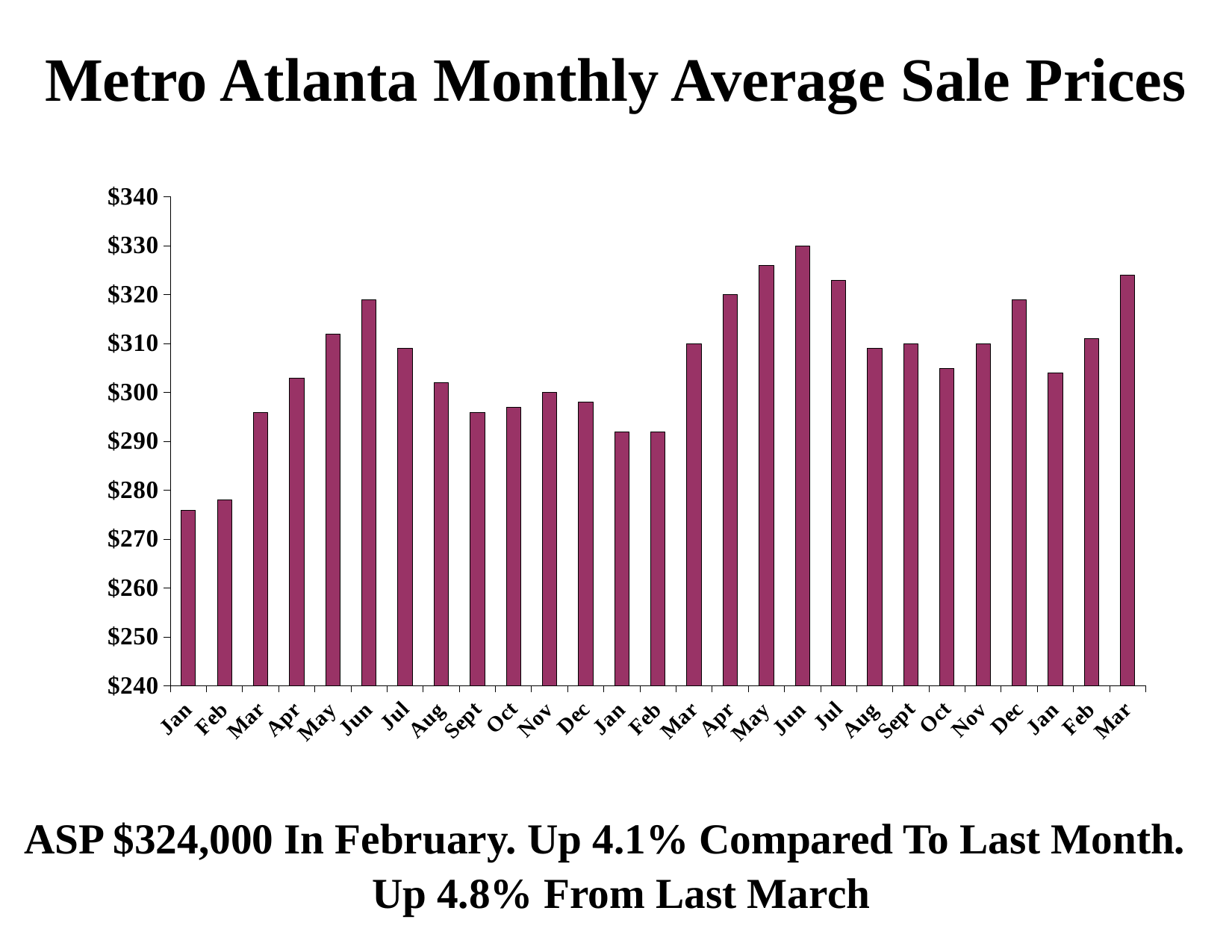
Is the value for the first Jun bar greater or less than $310? greater Which is larger, the first Mar bar or the first Jun bar? Jun Which month has the highest bar in the chart? Jun (the second Jun) Is the value for the first Jan bar greater or less than $280? less What kind of chart is shown on the slide? bar chart Do the values rise or fall from the first Jan to the first Jun? rise Which month has the lowest bar in the chart? Jan (the first Jan) Which is larger, the second May bar or the second Aug bar? May What is the title of the chart? Metro Atlanta Monthly Average Sale Prices How many bars are plotted in the chart? 27 Is the value for the last Mar bar greater or less than $320? greater